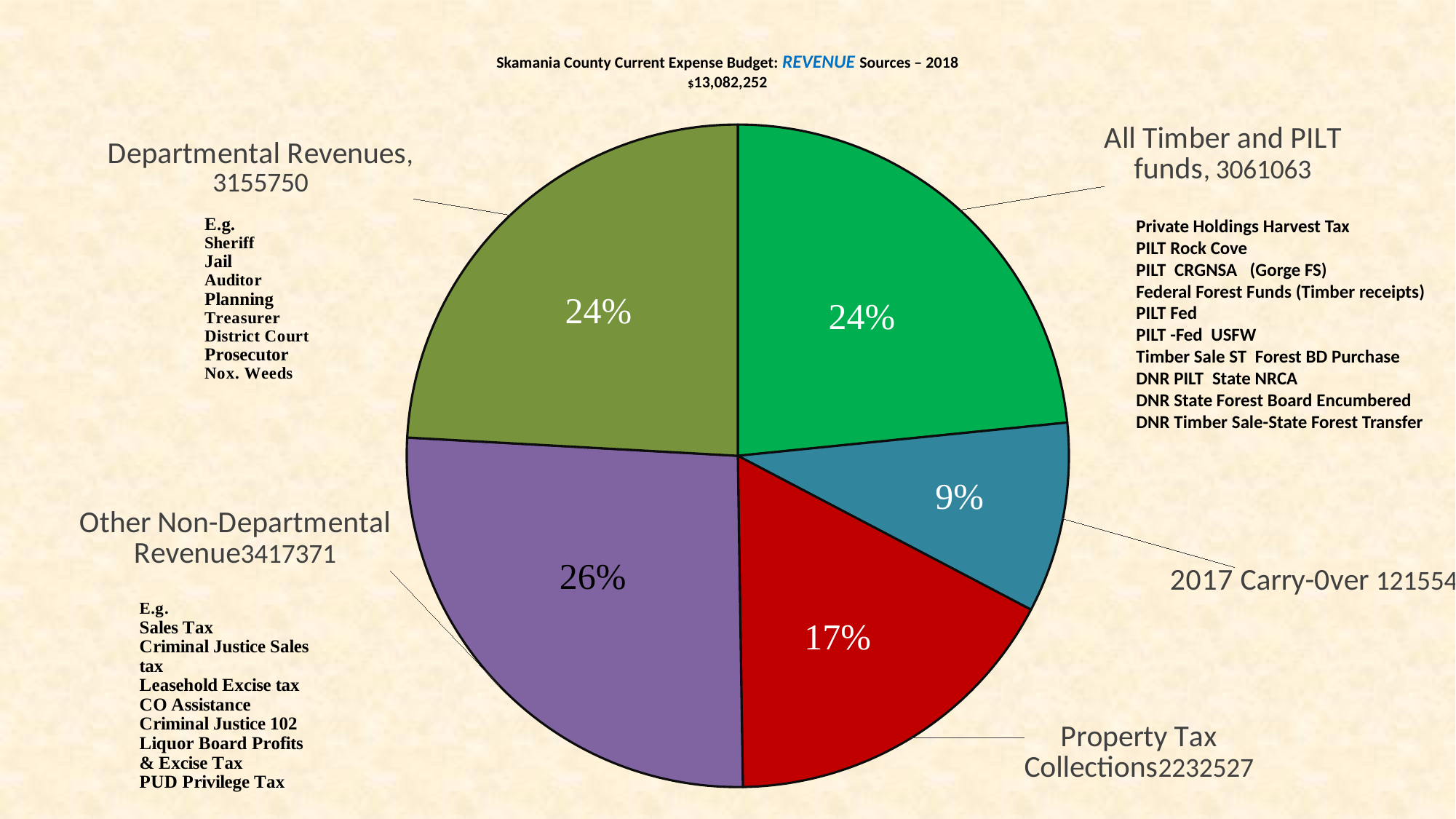
Which revenue source has the largest slice of the pie? Other Non-Departmental Revenue What type of chart is shown on the slide? Pie chart What share of the pie does Property Tax Collections represent? 17% What share of the pie does 2017 Carry-Over represent? 9% What is the value shown for Property Tax Collections? 2232527 What is the value shown for Departmental Revenues? 3155750 Which revenue source has the smallest slice of the pie? 2017 Carry-Over What total budget amount is shown in the chart title? $13,082,252 How many slices does the pie chart have? 5 What share of the pie does Other Non-Departmental Revenue represent? 26% What is the difference in percentage points between the Other Non-Departmental Revenue slice and the Property Tax Collections slice? 9